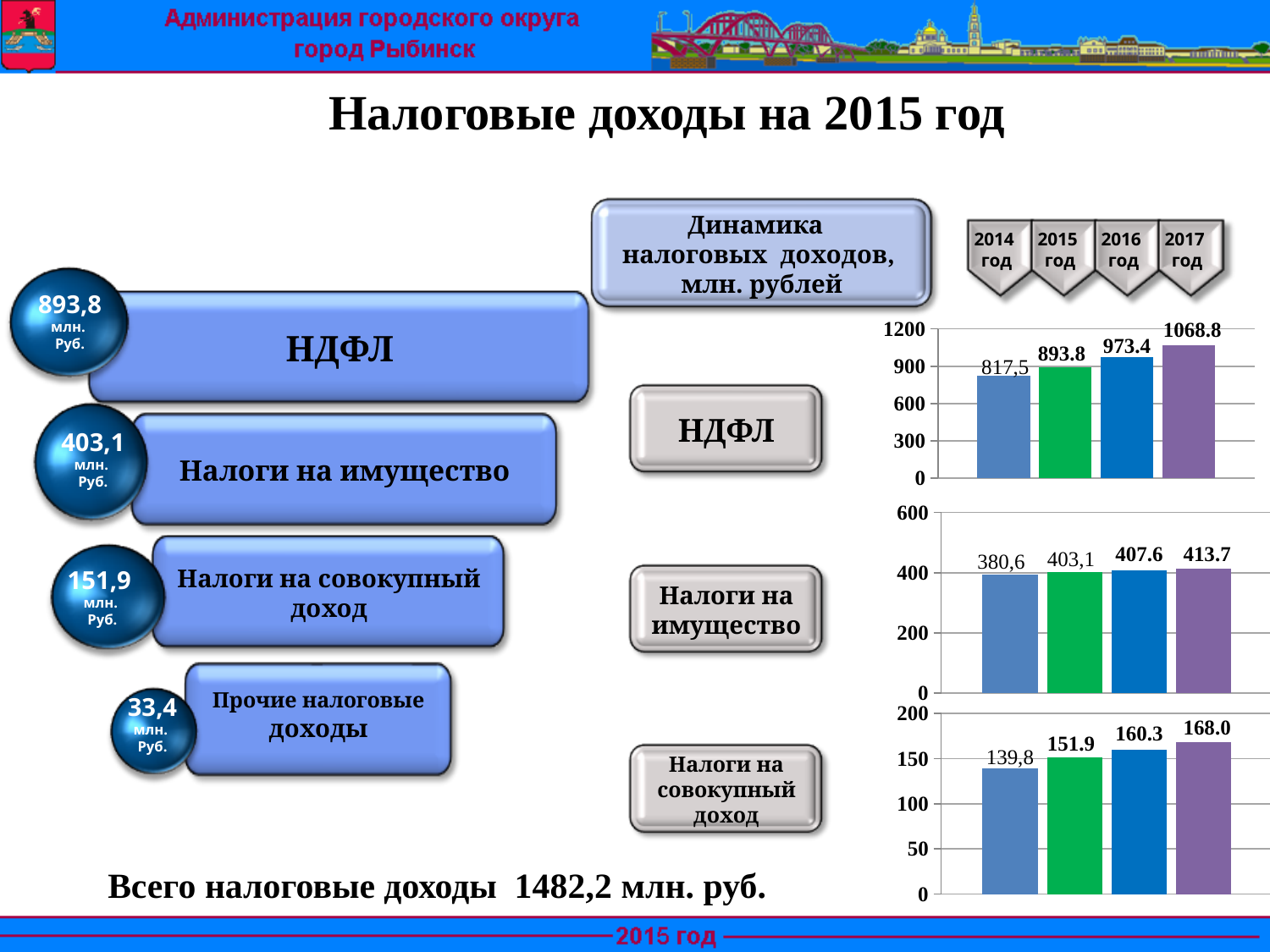
In the Налоги на совокупный доход chart, is the value for 2014 greater or less than 150? less In the Налоги на имущество chart, what is the value for 2017? 413.7 In the НДФЛ chart, which year has the highest value? 2017 How many bars does the НДФЛ chart have? 4 What type of chart is the Налоги на имущество chart? bar chart In the НДФЛ chart, what is the value for 2015? 893.8 In the Налоги на имущество chart, which year has the lowest value? 2014 In the НДФЛ chart, what is the value for 2014? 817,5 In the НДФЛ chart, do the values rise or fall from 2014 to 2017? rise In the Налоги на совокупный доход chart, which is larger, the value for 2015 or the value for 2017? 2017 In the Налоги на совокупный доход chart, what is the value for 2016? 160.3 In the Налоги на имущество chart, is the value for 2014 greater or less than 400? less